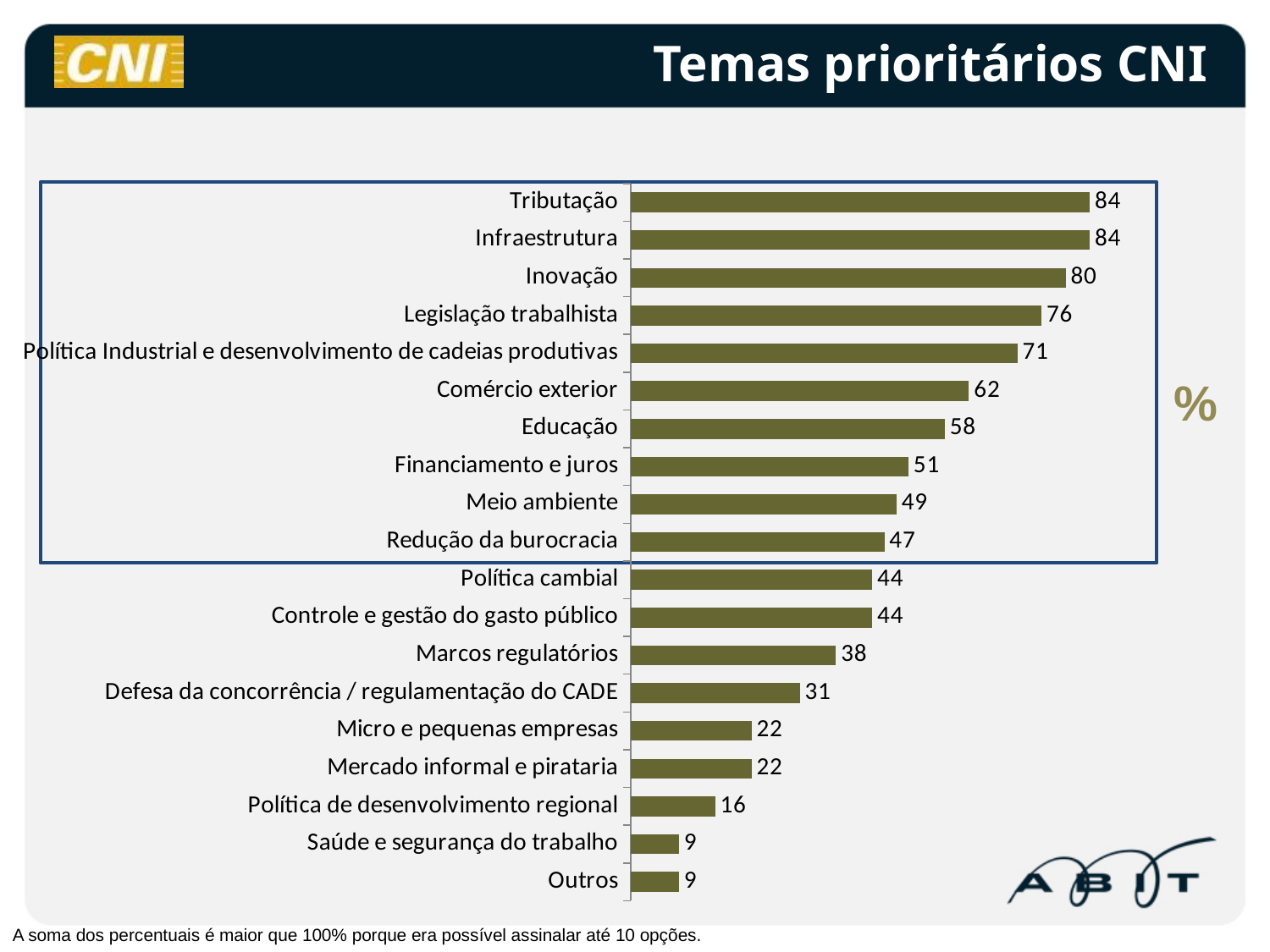
What is the difference between the values for Tributação and Educação? 26 What kind of chart is shown on the slide? bar chart What is the value for Comércio exterior? 62 What is the difference between the values for Legislação trabalhista and Meio ambiente? 27 What is the value for Inovação? 80 Which is larger, the value for Defesa da concorrência / regulamentação do CADE or the value for Micro e pequenas empresas? Defesa da concorrência / regulamentação do CADE Which is larger, the value for Financiamento e juros or the value for Política cambial? Financiamento e juros What is the title of the slide containing the chart? Temas prioritários CNI What is the value for Política de desenvolvimento regional? 16 What is the value for Redução da burocracia? 47 How many categories are shown in the chart? 19 What is the value for Marcos regulatórios? 38